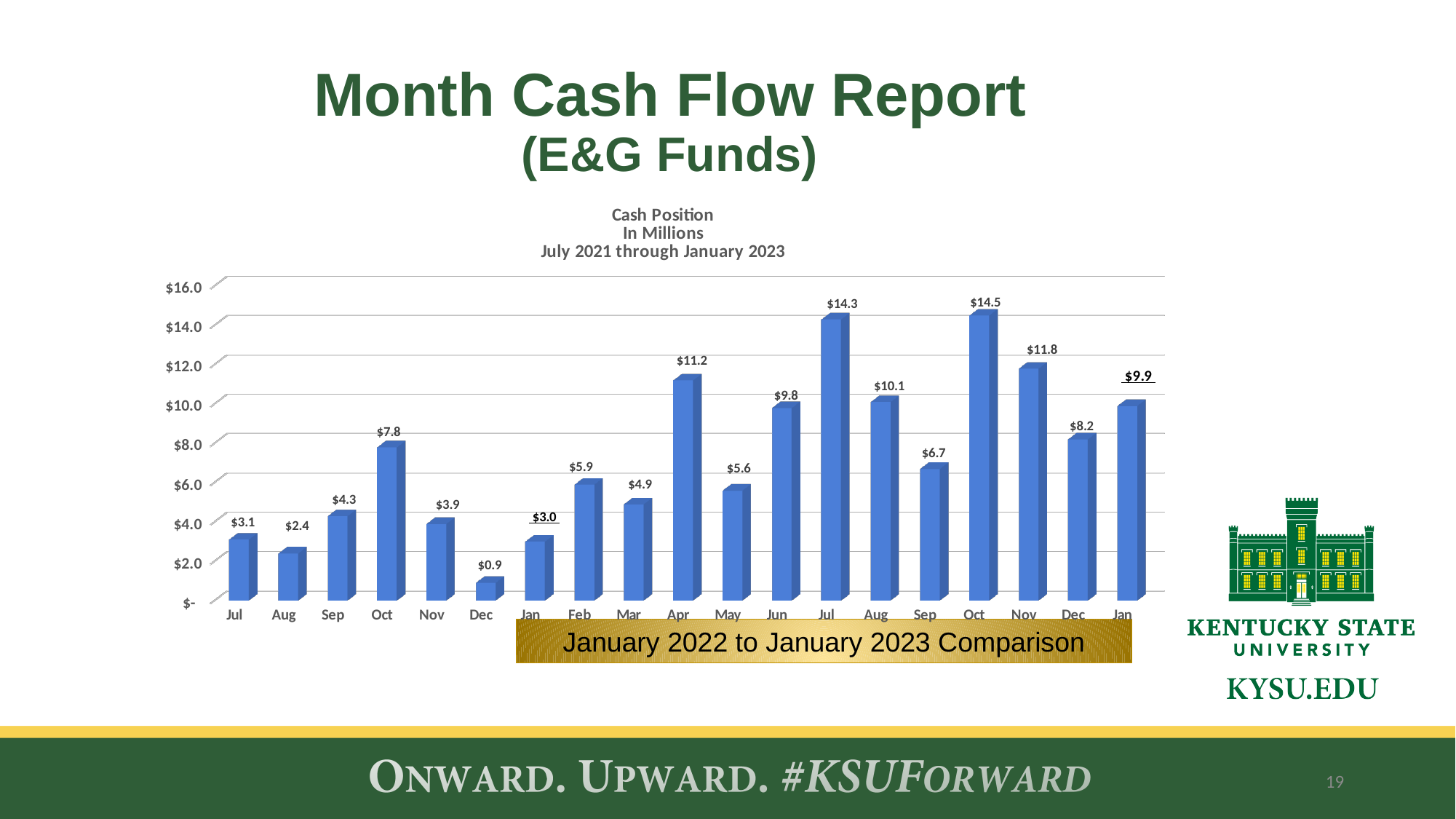
What is the difference between the first Sep bar ($4.3) and the second Sep bar ($6.7)? $2.4 What is the cash position for the Apr bar? $11.2 What is the difference between the January 2023 value ($9.9) and the January 2022 value ($3.0)? $6.9 What is the cash position for the last bar, Jan (January 2023)? $9.9 What period does the chart title say the data covers? July 2021 through January 2023 What is the cash position for the first Oct bar (October 2021)? $7.8 How many bars are plotted on the chart? 19 Which month has the lowest cash position on the chart? Dec (December 2021), $0.9 What type of chart is shown on the slide? Bar chart Which month has the highest cash position on the chart? Oct (October 2022), $14.5 Which is larger, the value for the second Jul bar (July 2022) or the second Nov bar (November 2022)? Jul (July 2022), $14.3 Is the value for the Feb bar greater or less than $4.0? greater